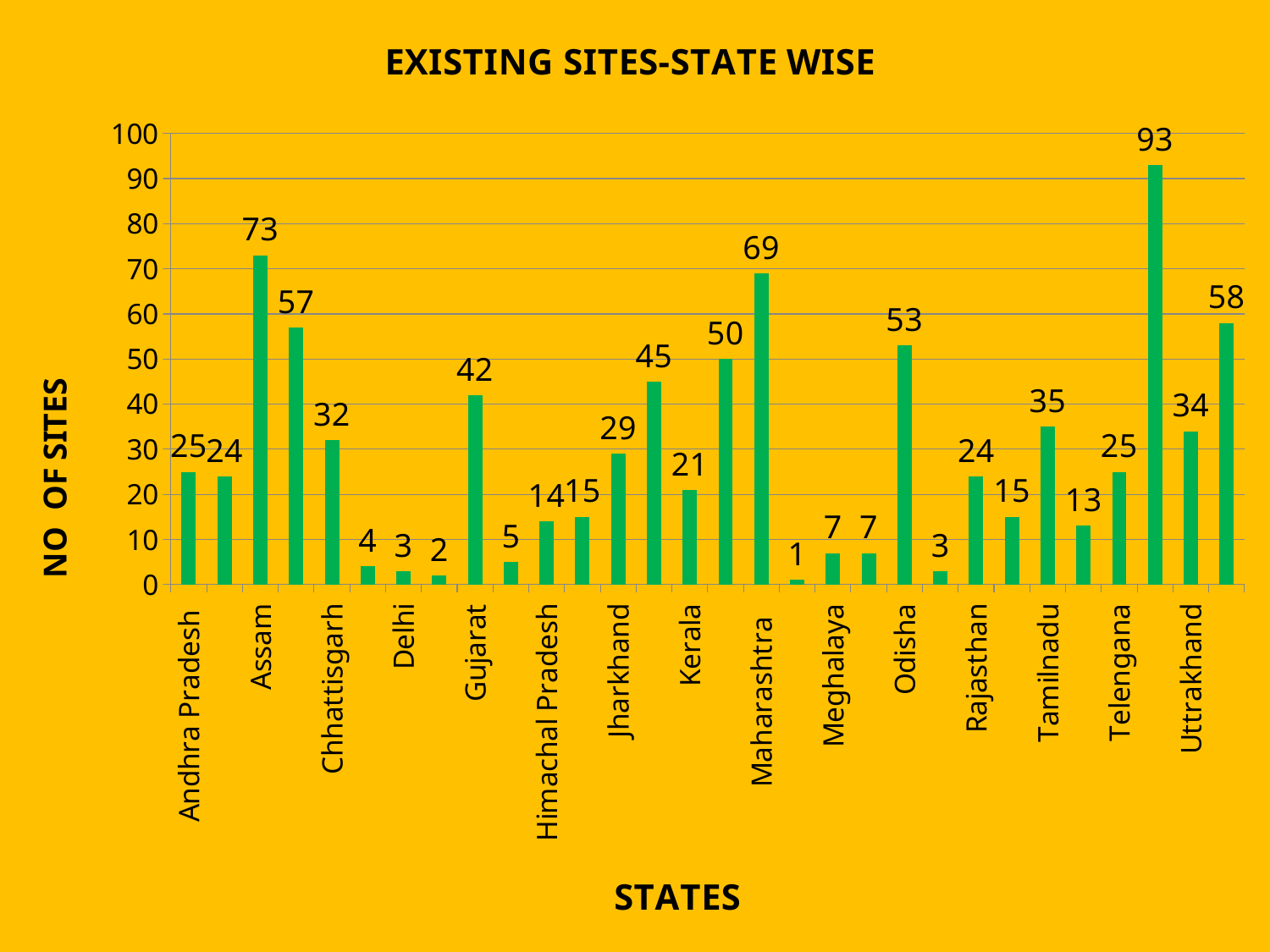
What is the number of sites for Gujarat? 42 What is the highest value shown on the chart? 93 What is the label on the vertical axis? NO OF SITES How many more sites does Uttrakhand have than Telengana? 9 What is the number of sites for Kerala? 21 How many existing sites does Maharashtra have? 69 What type of chart is shown on the slide? Bar chart What is the difference between the values for Assam and Chhattisgarh? 41 What value is shown for Odisha? 53 What is the title of the chart? EXISTING SITES-STATE WISE Which has more sites, Tamilnadu or Rajasthan? Tamilnadu How many sites are shown for Delhi? 3